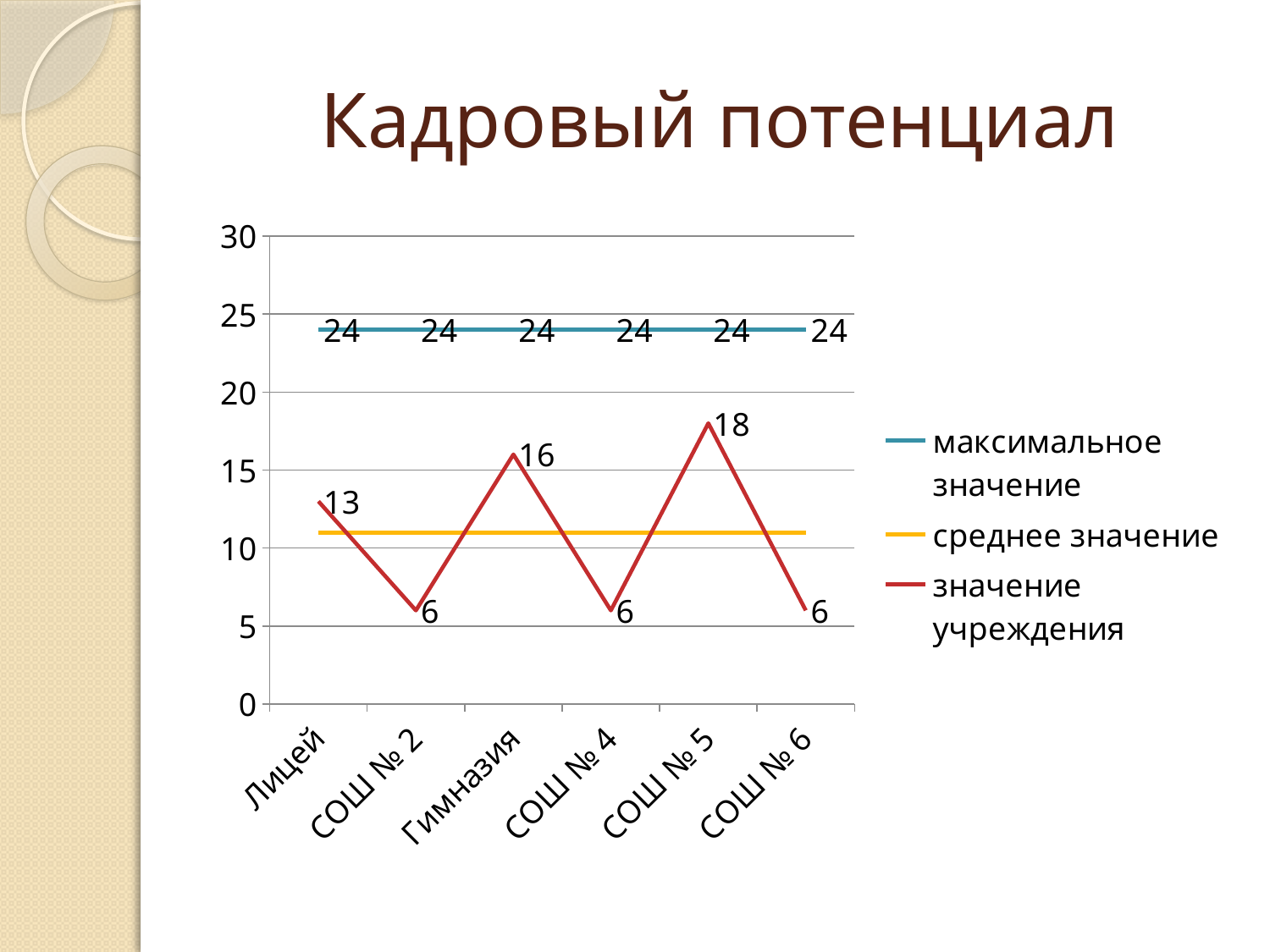
What is the difference between the "максимальное значение" and the "значение учреждения" for Лицей? 11 What is the value of "максимальное значение" for СОШ № 4? 24 What is the value of "значение учреждения" for Лицей? 13 How many categories are shown on the x axis? 6 Which category has the highest "значение учреждения"? СОШ № 5 Is the "среднее значение" line greater or less than 10? greater What kind of chart is shown on the slide? line chart What is the value of "значение учреждения" for Гимназия? 16 What is the value of "значение учреждения" for СОШ № 5? 18 Which is larger: the "значение учреждения" for Лицей or for СОШ № 2? Лицей How many series does the legend list? 3 What is the difference between the "значение учреждения" for СОШ № 5 and for Гимназия? 2